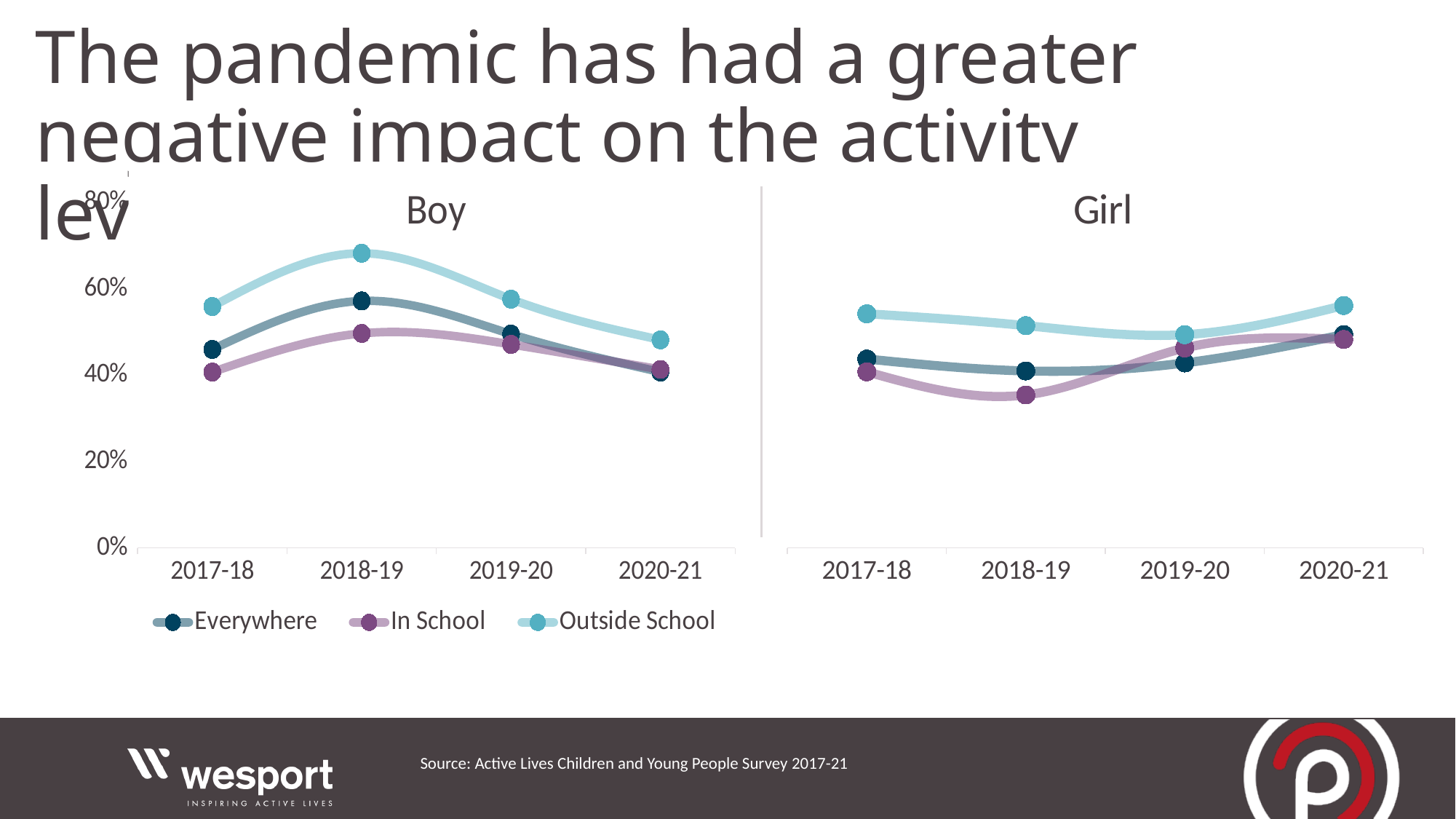
What kind of chart is the Boy chart? line chart In the Boy chart, is the Outside School value for 2020-21 greater or less than 60%? less Which is larger: the Everywhere value for 2018-19 in the Boy chart or in the Girl chart? Boy How many time periods are shown on the x axis of the Girl chart? 4 In the Boy chart, which year has the highest Outside School value? 2018-19 In the Girl chart, which year has the lowest In School value? 2018-19 In the Girl chart, is the In School value for 2018-19 greater or less than 40%? less How many series does the legend list? 3 In the Boy chart, is the Outside School value for 2018-19 greater or less than 60%? greater In the Boy chart, does the Outside School line rise or fall from 2018-19 to 2020-21? fall In the Girl chart, which series has the highest value in 2017-18? Outside School In the Girl chart, does the In School line rise or fall from 2018-19 to 2020-21? rise